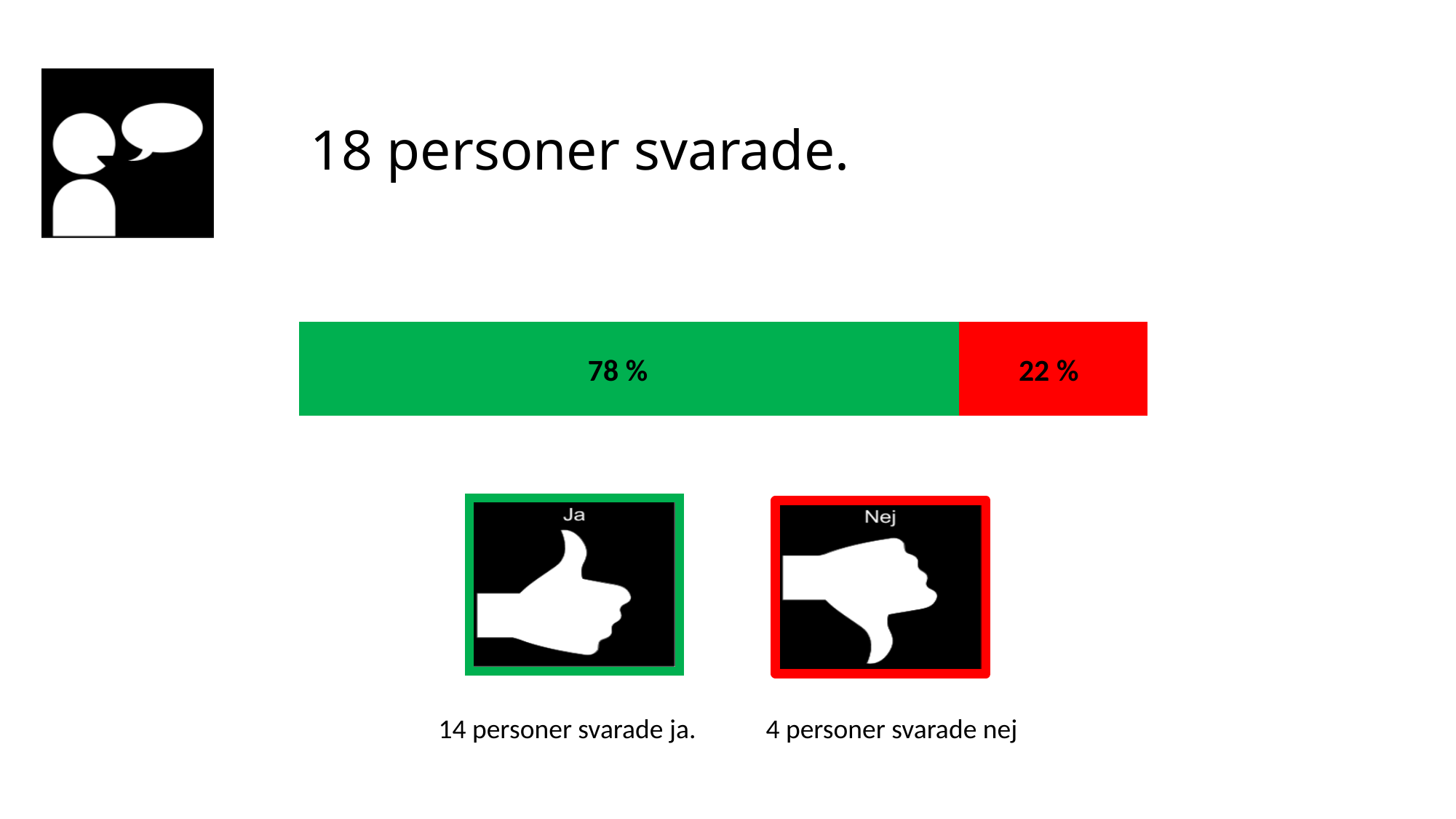
What kind of chart is shown on the slide? stacked bar chart Which response has the smallest share of the bar, Ja or Nej? Nej What percentage is shown in the green segment of the bar? 78 % What is the total of the two segments in the bar? 100 % Is the bar on the slide horizontal or vertical? horizontal Which response has the largest share of the bar, Ja or Nej? Ja How many people answered in total according to the slide? 18 How many segments does the bar have? 2 Which segment of the bar is larger, the green one or the red one? the green one What is the difference in percentage points between the green segment and the red segment? 56 What colour is the segment representing Ja? green What percentage is shown in the red segment of the bar? 22 %